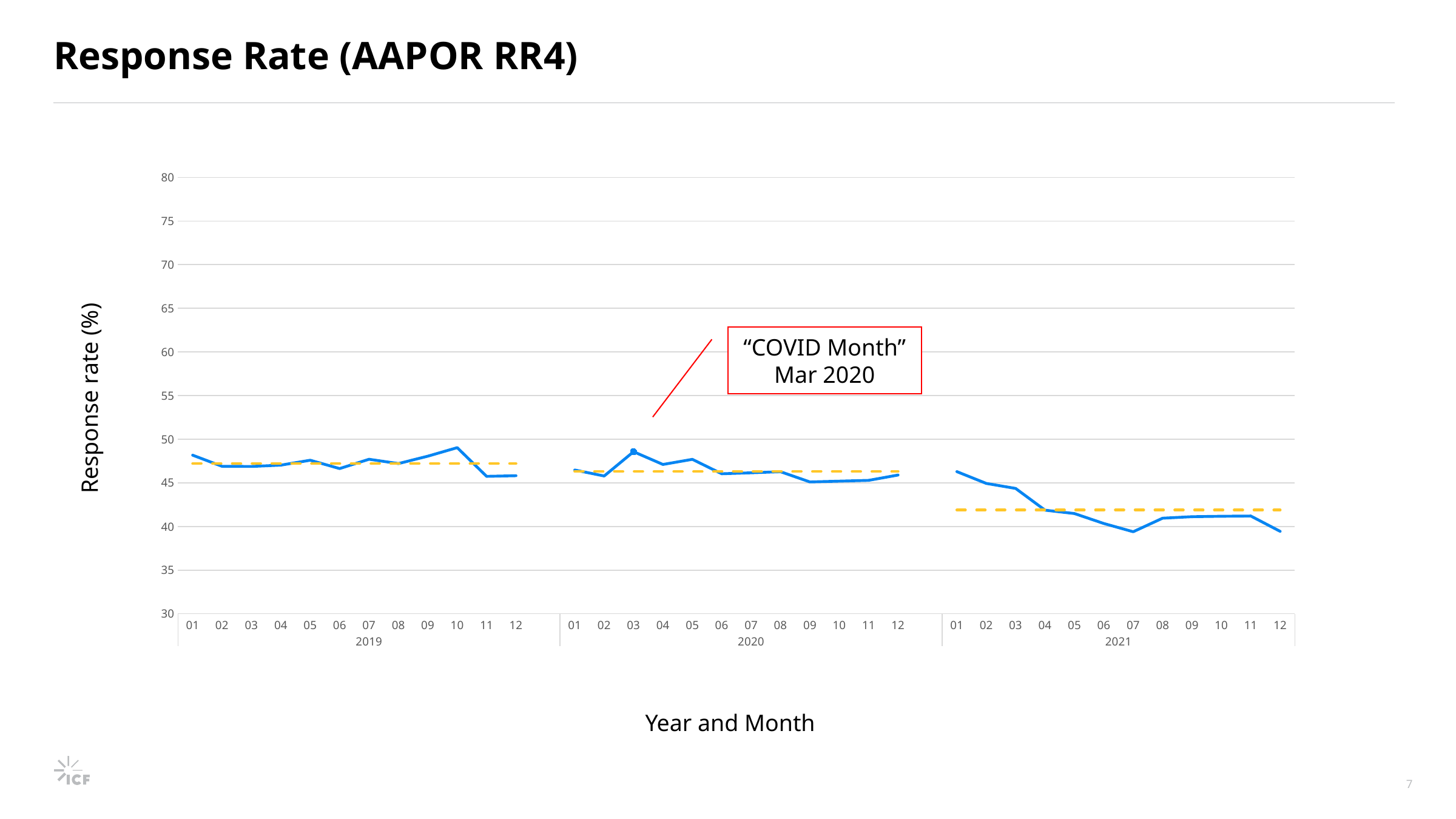
What is the label of the vertical axis? Response rate (%) Is the response rate for month 10 of 2019 greater or less than 45? greater Which is higher, the response rate for month 10 of 2019 or month 07 of 2021? month 10 of 2019 How many years are shown along the x axis? 3 Is the response rate for month 04 of 2021 greater or less than 45? less Is the response rate for month 07 of 2021 greater or less than 40? less Do the response rates generally rise or fall across the months of 2021? fall What kind of chart is shown on the slide? line chart Which month is annotated as the "COVID Month"? Mar 2020 What is the title of the chart on the slide? Response Rate (AAPOR RR4) How many monthly data points are plotted in total across 2019, 2020 and 2021? 36